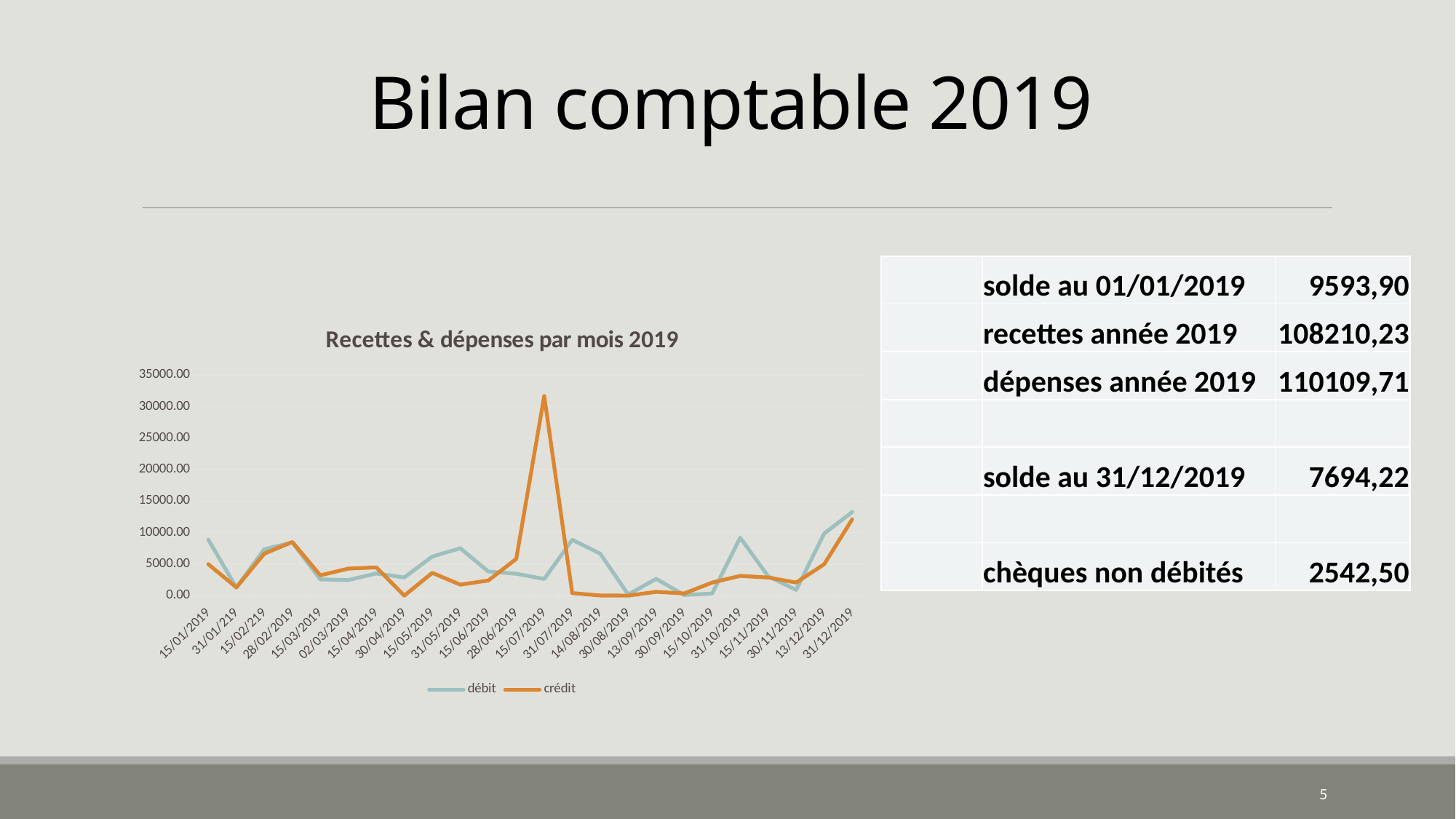
What are the two series named in the chart legend? débit and crédit On which date does the débit series reach its highest value? 31/12/2019 Is the crédit value on 15/07/2019 greater or less than 25000.00? greater Is the débit value on 31/10/2019 greater or less than 5000.00? greater Is the débit value on 15/07/2019 greater or less than 5000.00? less What is the title of the chart? Recettes & dépenses par mois 2019 On 31/10/2019, which series has the larger value, débit or crédit? débit How many series does the legend of the chart list? 2 How many dates are shown along the x axis of the chart? 24 What kind of chart is shown on the slide? line chart On 15/07/2019, which series has the larger value, débit or crédit? crédit On which date does the crédit series reach its highest value? 15/07/2019